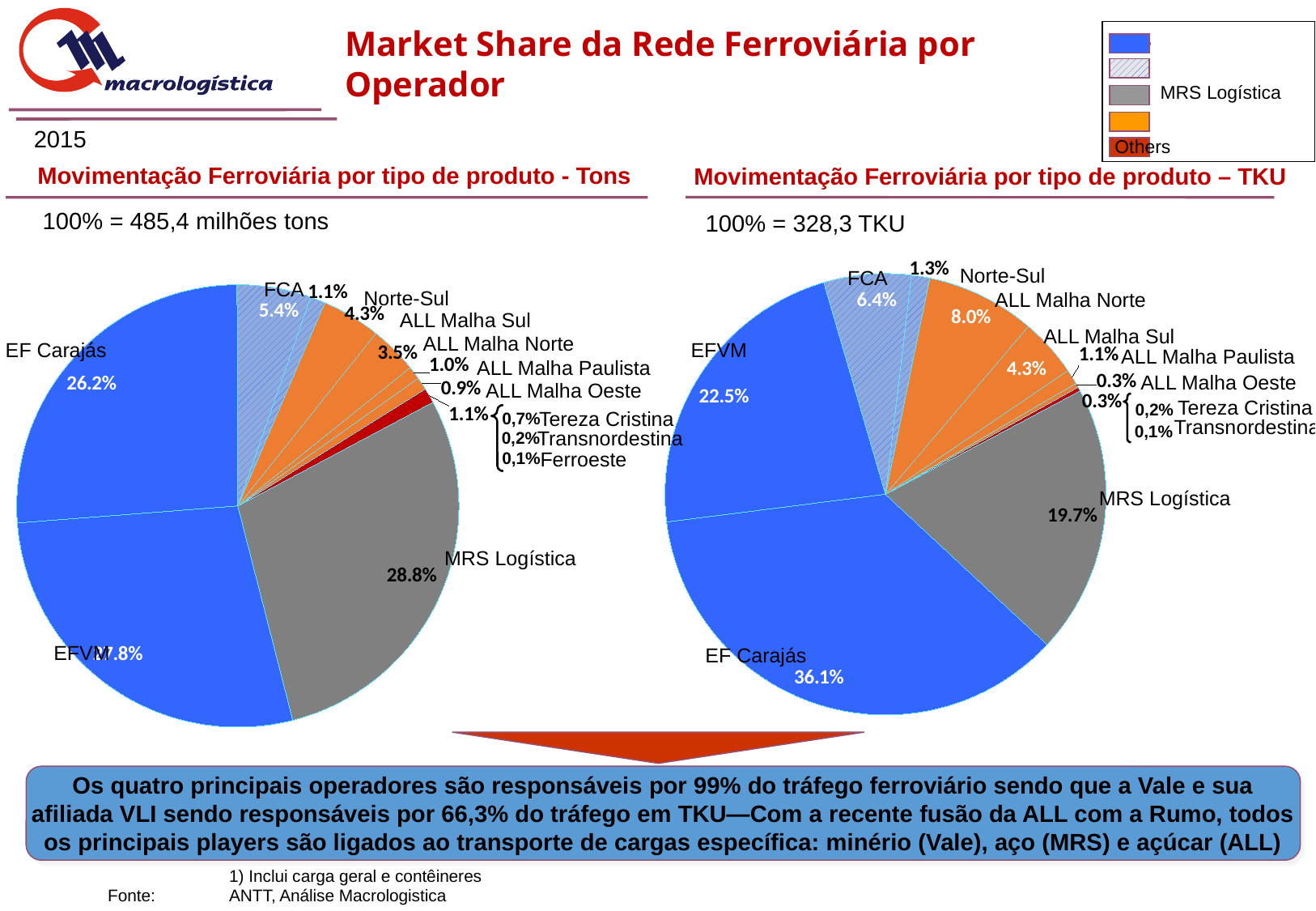
In the left chart (Tons), what is the difference between the shares of FCA and ALL Malha Sul? 1.1% In the right chart (TKU), which operator has the largest share? EF Carajás What type of chart is used on this slide? Pie chart In the right chart (TKU), what is the difference between the shares of EF Carajás and MRS Logística? 16.4% In the left chart (Tons), what share does EF Carajás hold? 26.2% In the left chart (Tons), which is larger: the share of ALL Malha Norte or the share of Norte-Sul? ALL Malha Norte In the right chart (TKU), which is larger: the share of FCA or the share of ALL Malha Sul? FCA What total does 100% represent in the left chart (Tons)? 485,4 milhões tons In the left chart (Tons), what share does MRS Logística hold? 28.8% In the right chart (TKU), what share does ALL Malha Norte hold? 8.0% In the right chart (TKU), what share does EF Carajás hold? 36.1% In the left chart (Tons), which operator has the largest share? MRS Logística